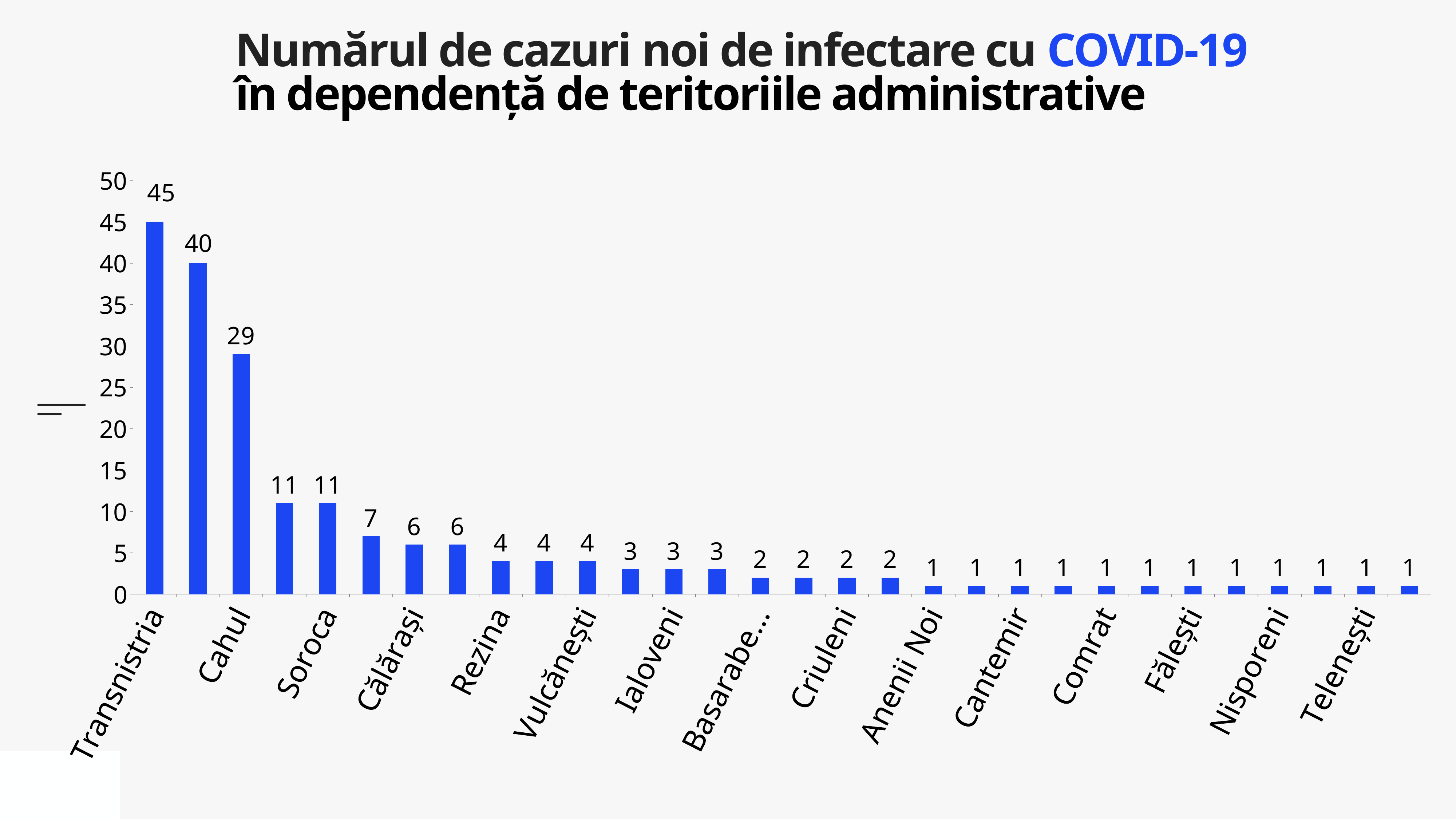
Is the value for Transnistria greater or less than 40? greater What kind of chart is shown on the slide? bar chart What is the value of the second bar from the left? 40 Which territory has the highest number of new cases? Transnistria What is the difference between the highest bar (45) and the second highest bar (40)? 5 What is the value of the last bar on the right? 1 How many bars are plotted in the chart? 30 What colour are the bars in the chart? blue What is the maximum value shown on the vertical axis? 50 What is the value of the third bar from the left? 29 What is the value for Transnistria? 45 Do the values rise or fall from left to right along the x axis? fall